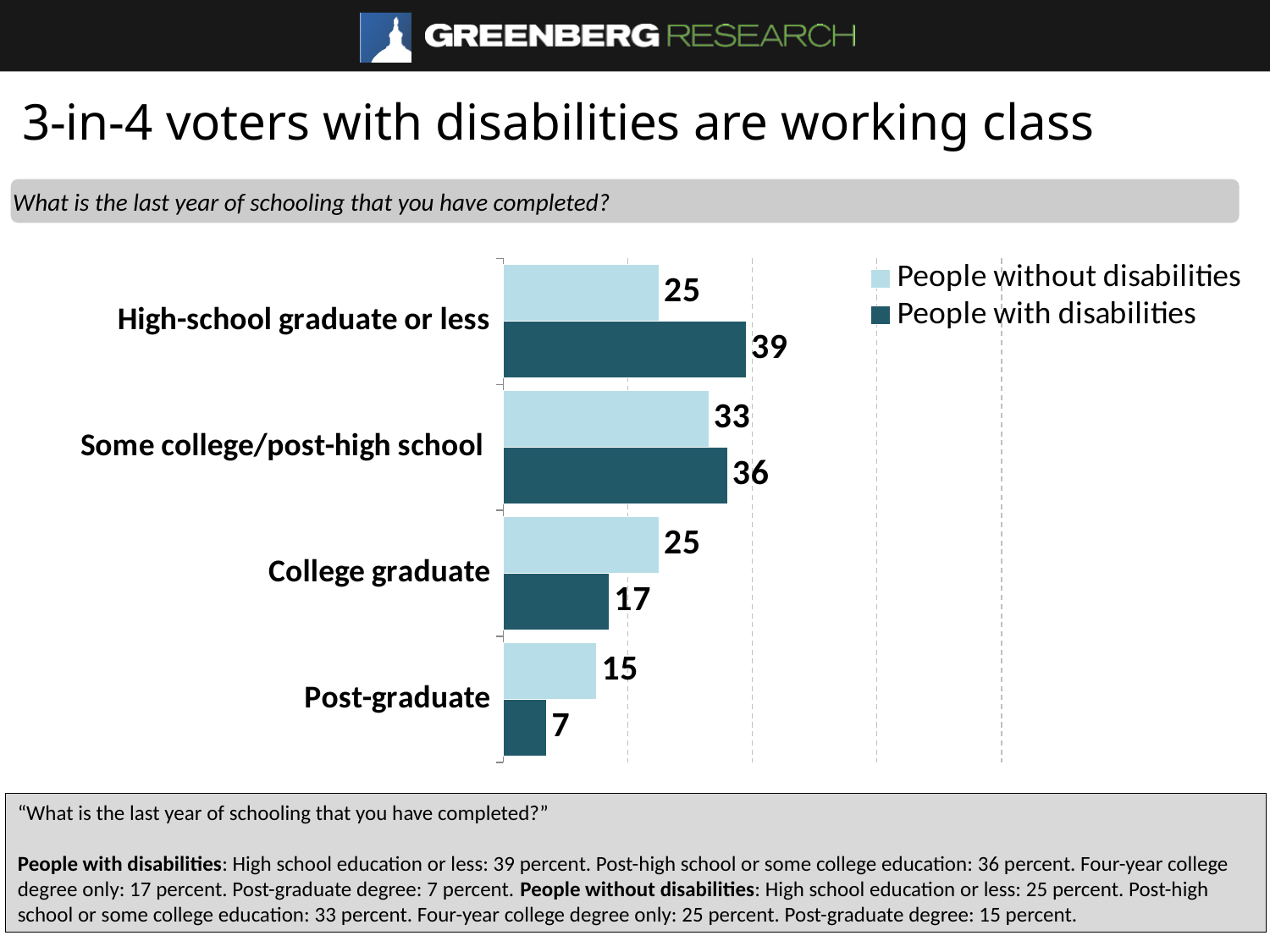
What is the value for People without disabilities in the Post-graduate category? 15 What is the value for People with disabilities in the High-school graduate or less category? 39 What is the difference between People without disabilities and People with disabilities in the Post-graduate category? 8 What is the value for People with disabilities in the College graduate category? 17 What is the difference between People with disabilities and People without disabilities in the High-school graduate or less category? 14 How many series does the legend list? 2 Which category has the highest value for People with disabilities? High-school graduate or less Which category has the lowest value for People without disabilities? Post-graduate Which series is shown in the darker colour in the legend? People with disabilities How many education categories are shown in the chart? 4 In the College graduate category, which series has the larger value? People without disabilities What kind of chart is shown on the slide? Bar chart